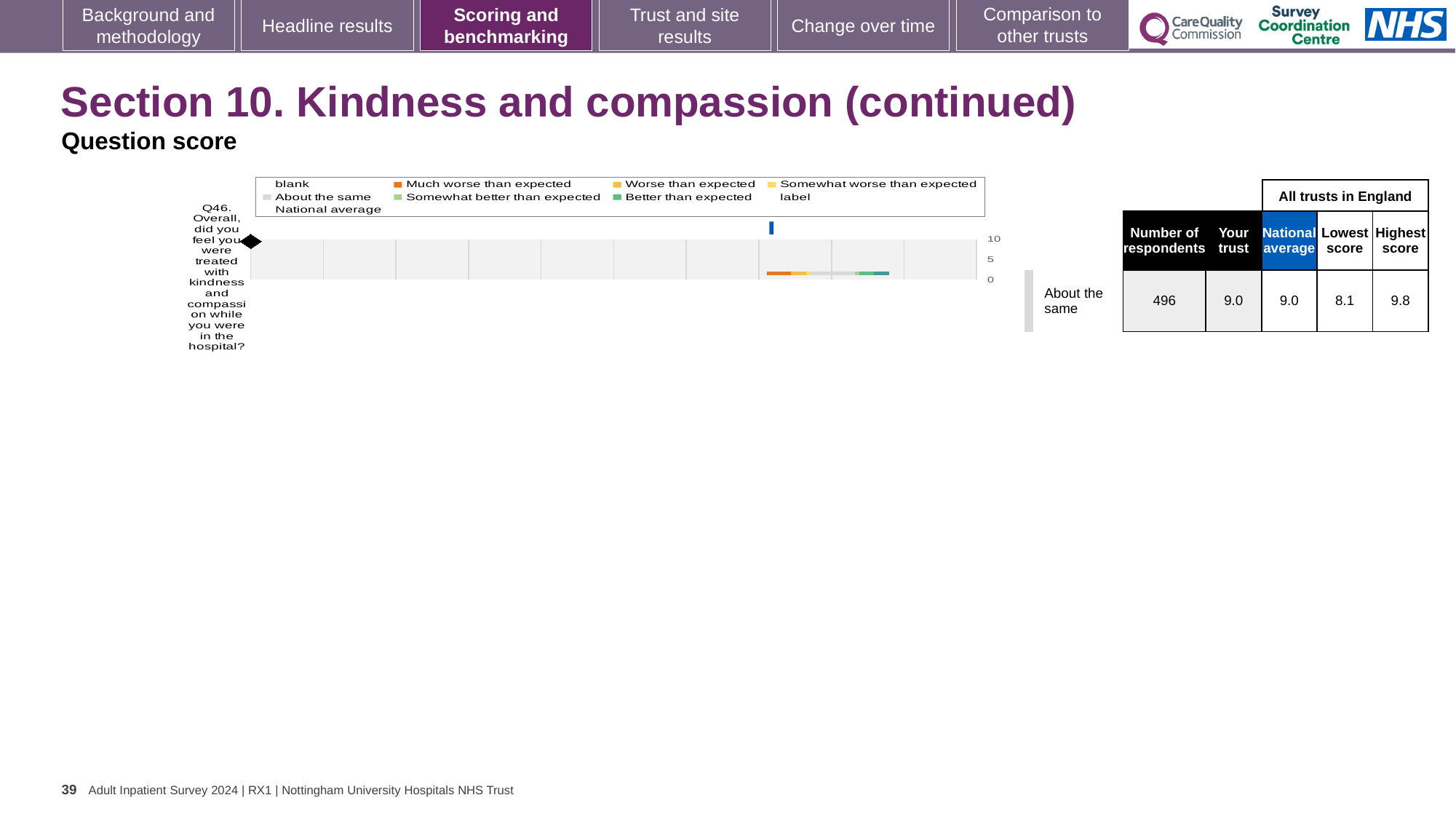
Which survey question is plotted in the chart? Q46 What is the difference between the highest score and the trust's score for Q46? 0.8 What kind of chart is shown on the slide? bar chart How many respondents are shown for Q46? 496 What is the lowest score among all trusts in England for Q46? 8.1 What is the highest score among all trusts in England for Q46? 9.8 What colour is the legend marker for 'Much worse than expected'? orange Is the trust's score for Q46 greater or less than 5 on the chart axis? greater Which benchmarking category is the trust's score for Q46 placed in? About the same What is the national average score for Q46? 9.0 What is the difference between the highest score and the lowest score for Q46? 1.7 What is the 'Your trust' score for Q46? 9.0